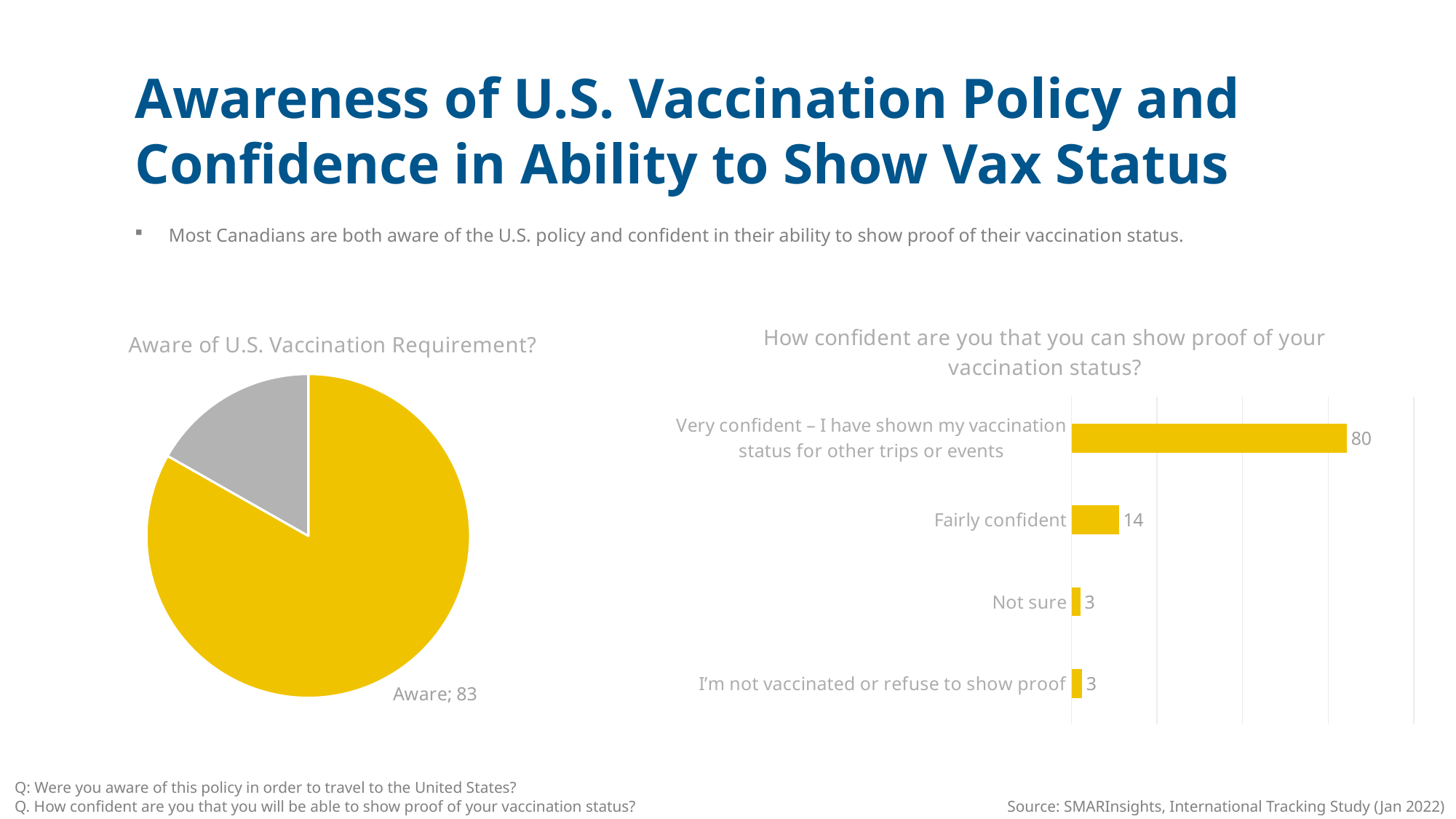
In the 'How confident are you that you can show proof of your vaccination status?' chart, what is the value for 'Very confident – I have shown my vaccination status for other trips or events'? 80 In the 'Aware of U.S. Vaccination Requirement?' chart, what value is shown for the 'Aware' slice? 83 In the 'How confident are you that you can show proof of your vaccination status?' chart, what is the value for 'I'm not vaccinated or refuse to show proof'? 3 In the 'How confident are you that you can show proof of your vaccination status?' chart, what is the value for 'Not sure'? 3 What kind of chart is the 'Aware of U.S. Vaccination Requirement?' chart? pie chart What kind of chart is the 'How confident are you that you can show proof of your vaccination status?' chart? bar chart In the 'How confident are you that you can show proof of your vaccination status?' chart, what is the difference between the 'Very confident' value and the 'Fairly confident' value? 66 In the 'How confident are you that you can show proof of your vaccination status?' chart, which is larger: 'Fairly confident' or 'Not sure'? Fairly confident In the 'How confident are you that you can show proof of your vaccination status?' chart, which category has the highest value? Very confident – I have shown my vaccination status for other trips or events In the 'Aware of U.S. Vaccination Requirement?' pie chart, what colour is the 'Aware' slice? yellow In the 'How confident are you that you can show proof of your vaccination status?' chart, how many categories are shown? 4 In the 'How confident are you that you can show proof of your vaccination status?' chart, what is the value for 'Fairly confident'? 14